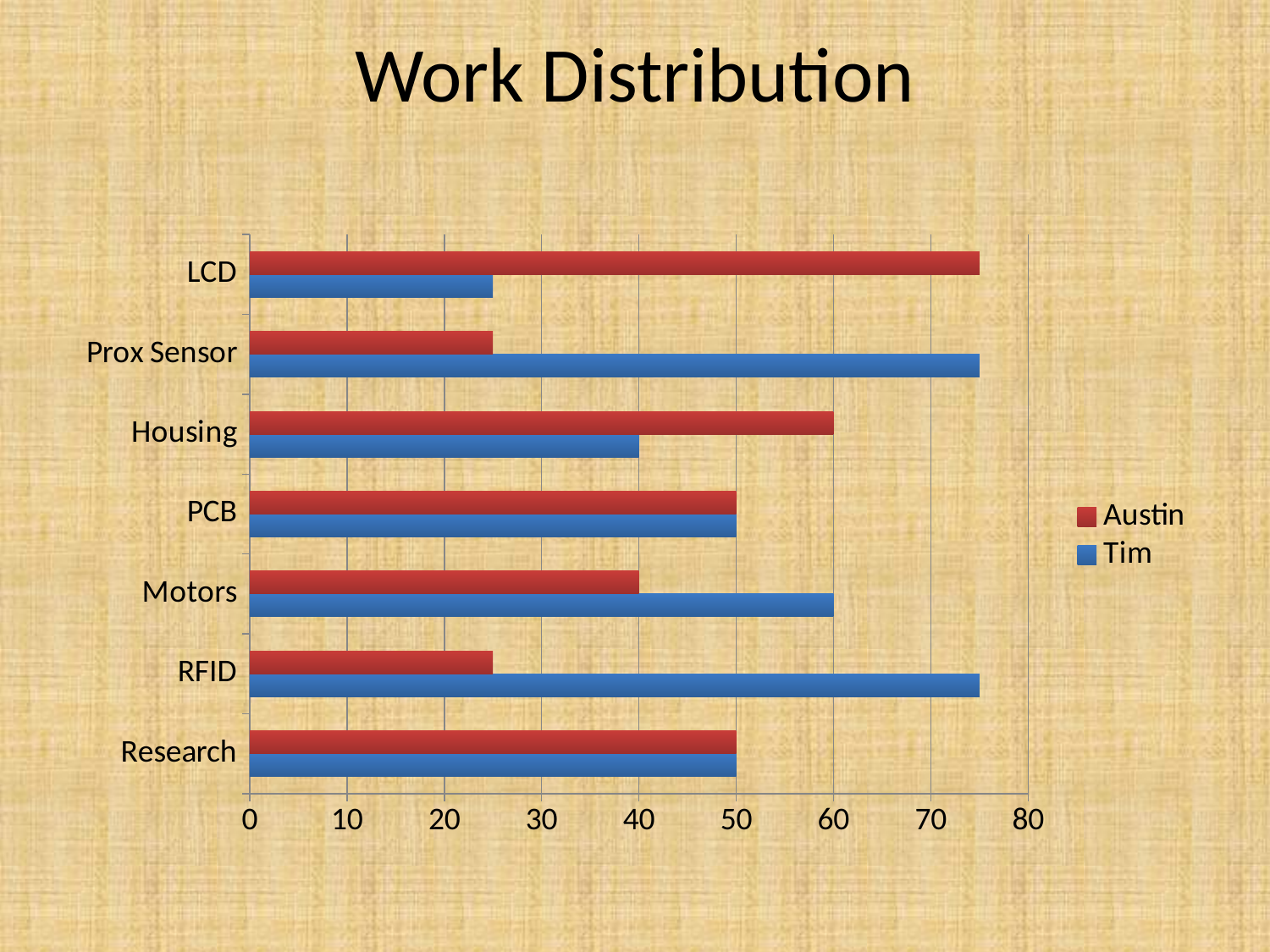
How many series does the legend list? 2 What is the difference between Austin's and Tim's values for Housing? 20 What is the title of the chart? Work Distribution Is the value for Tim in the Prox Sensor category greater or less than 70? greater What is the value for Tim in the Motors category? 60 How many categories are shown on the chart? 7 Is the value for Austin in the LCD category greater or less than 70? greater What is the value for Tim in the Housing category? 40 Which is larger for RFID, Austin's value or Tim's value? Tim What is the value for Austin in the Housing category? 60 What kind of chart is shown on the slide? bar chart What is the value for Austin in the PCB category? 50